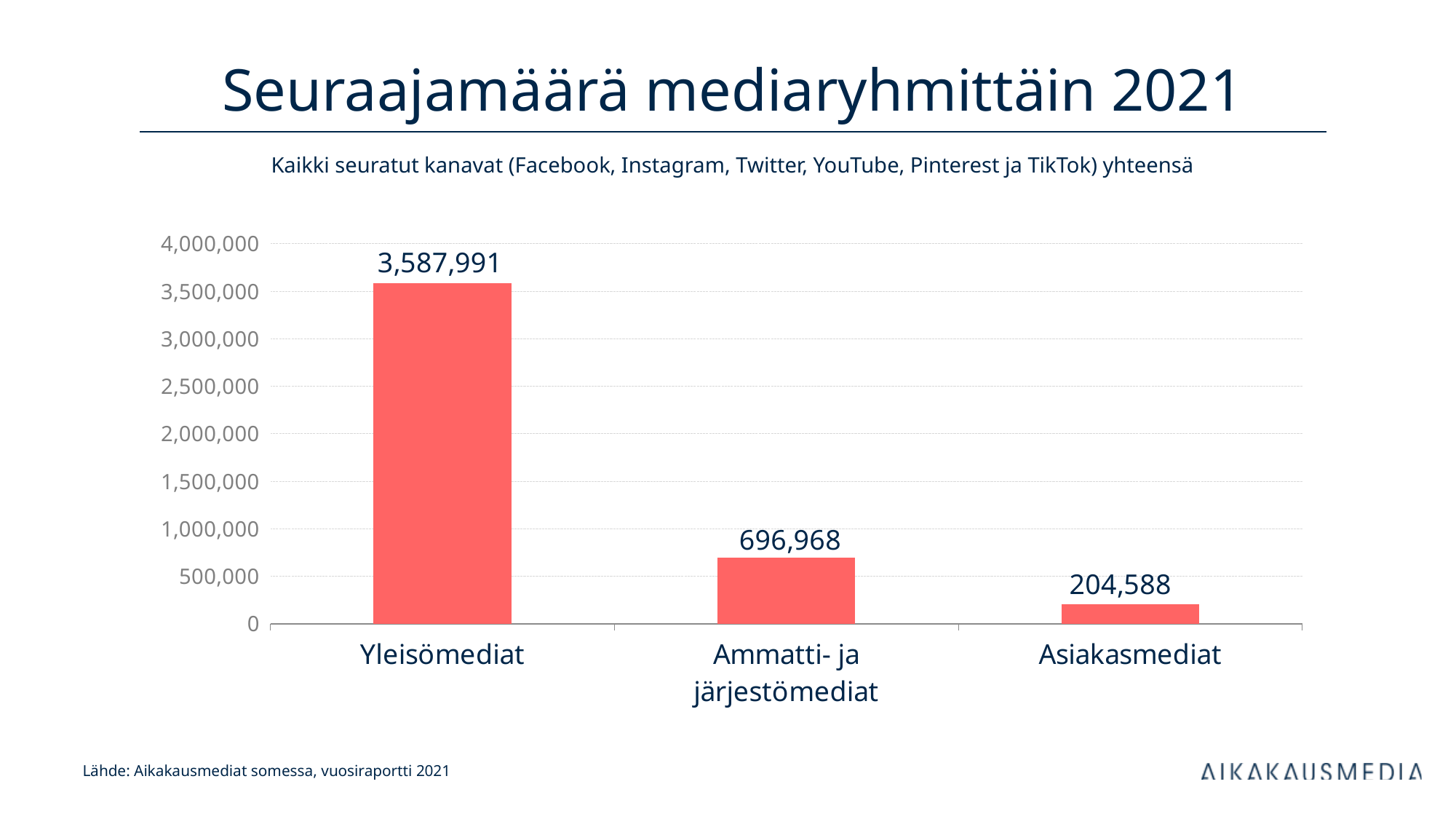
What is the value for Asiakasmediat? 204,588 Which category has the highest value? Yleisömediat What is the value for Yleisömediat? 3,587,991 How many categories are shown in the chart? 3 What is the value for Ammatti- ja järjestömediat? 696,968 Which is larger, the value for Ammatti- ja järjestömediat or the value for Asiakasmediat? Ammatti- ja järjestömediat Which category has the lowest value? Asiakasmediat What is the title of the chart? Seuraajamäärä mediaryhmittäin 2021 What kind of chart is shown on the slide? bar chart Is the value for Yleisömediat greater or less than 3,500,000? greater What is the difference between the values for Ammatti- ja järjestömediat and Asiakasmediat? 492,380 What is the difference between the values for Yleisömediat and Ammatti- ja järjestömediat? 2,891,023